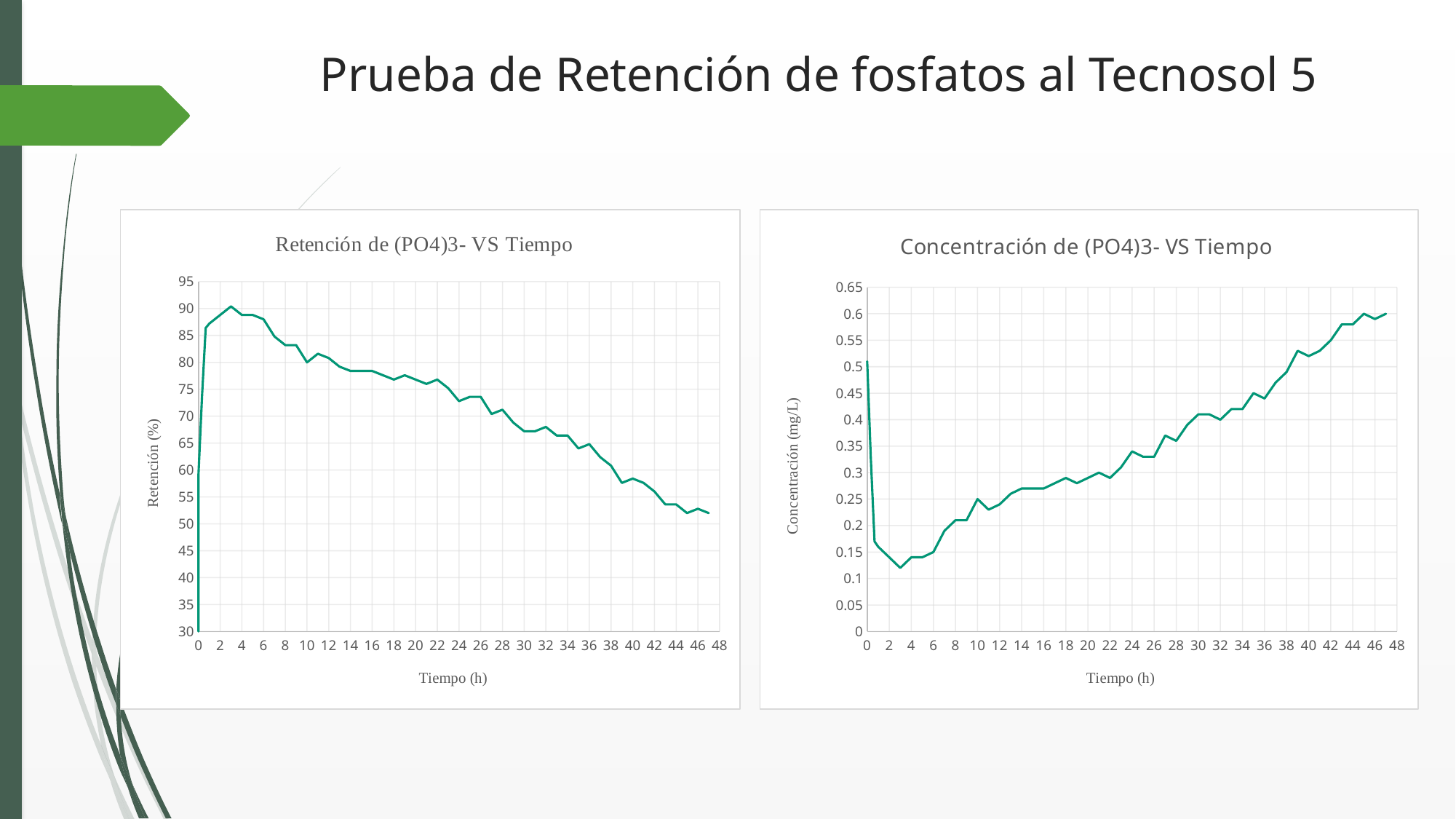
In the right chart 'Concentración de (PO4)3- VS Tiempo', is the concentration at 40 h greater or less than 0.5? greater What kind of chart is the left chart titled 'Retención de (PO4)3- VS Tiempo'? line chart In the right chart 'Concentración de (PO4)3- VS Tiempo', is the concentration at 46 h greater or less than 0.55? greater In the left chart 'Retención de (PO4)3- VS Tiempo', is the retention value at 30 h greater or less than 70? less What is the x-axis label of the left chart 'Retención de (PO4)3- VS Tiempo'? Tiempo (h) In the left chart 'Retención de (PO4)3- VS Tiempo', do the retention values rise or fall between 6 h and 47 h? fall What is the y-axis label of the right chart 'Concentración de (PO4)3- VS Tiempo'? Concentración (mg/L) What kind of chart is the right chart titled 'Concentración de (PO4)3- VS Tiempo'? line chart In the right chart 'Concentración de (PO4)3- VS Tiempo', do the concentration values rise or fall between 4 h and 47 h? rise